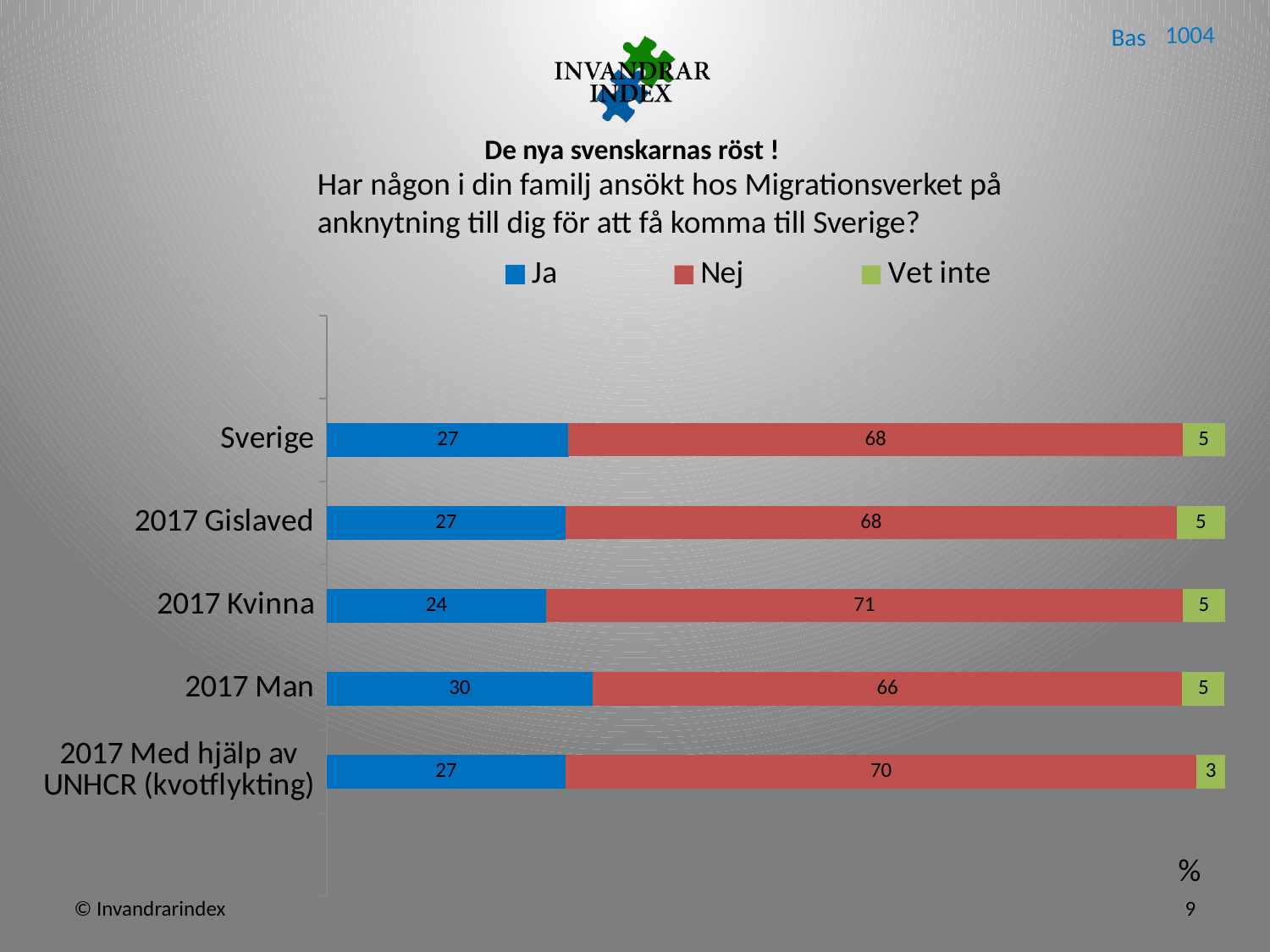
How many series does the legend list? 3 What is the difference between the "Nej" values for 2017 Kvinna and 2017 Man? 5 Which is larger, the "Ja" value for 2017 Man or for 2017 Kvinna? 2017 Man Which category has the highest "Ja" value? 2017 Man What kind of chart is shown on the slide? Stacked bar chart Which category has the lowest "Ja" value? 2017 Kvinna What is the total of the stacked bar for 2017 Gislaved? 100 How many categories are shown on the chart? 5 What is the "Nej" value for 2017 Kvinna? 71 What is the "Vet inte" value for 2017 Med hjälp av UNHCR (kvotflykting)? 3 What is the "Ja" value for 2017 Man? 30 What is the "Nej" value for Sverige? 68